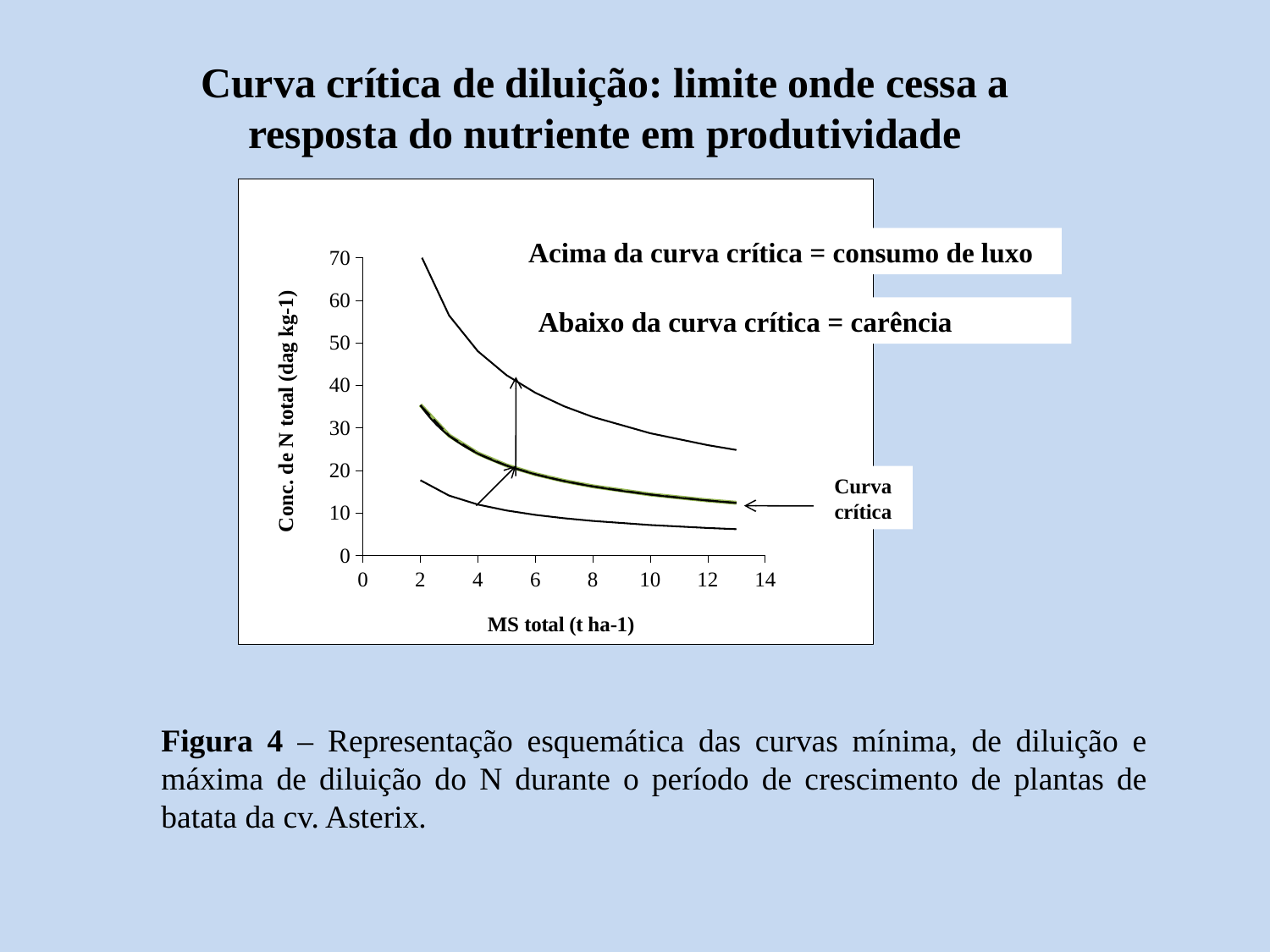
Is the value of the top curve at MS total 12 greater or less than 20? greater What is the title of the y axis of the chart? Conc. de N total (dag kg-1) Do the curves rise or fall as MS total increases along the x axis? fall At MS total 8, which curve has the higher value, the top curve or the curva crítica? the top curve What is the title of the x axis of the chart? MS total (t ha-1) What kind of chart is shown on the slide? line chart Is the value of the bottom curve at MS total 12 greater or less than 10? less Is the value of the top curve at MS total 4 greater or less than 40? greater How many curves are plotted on the chart? 3